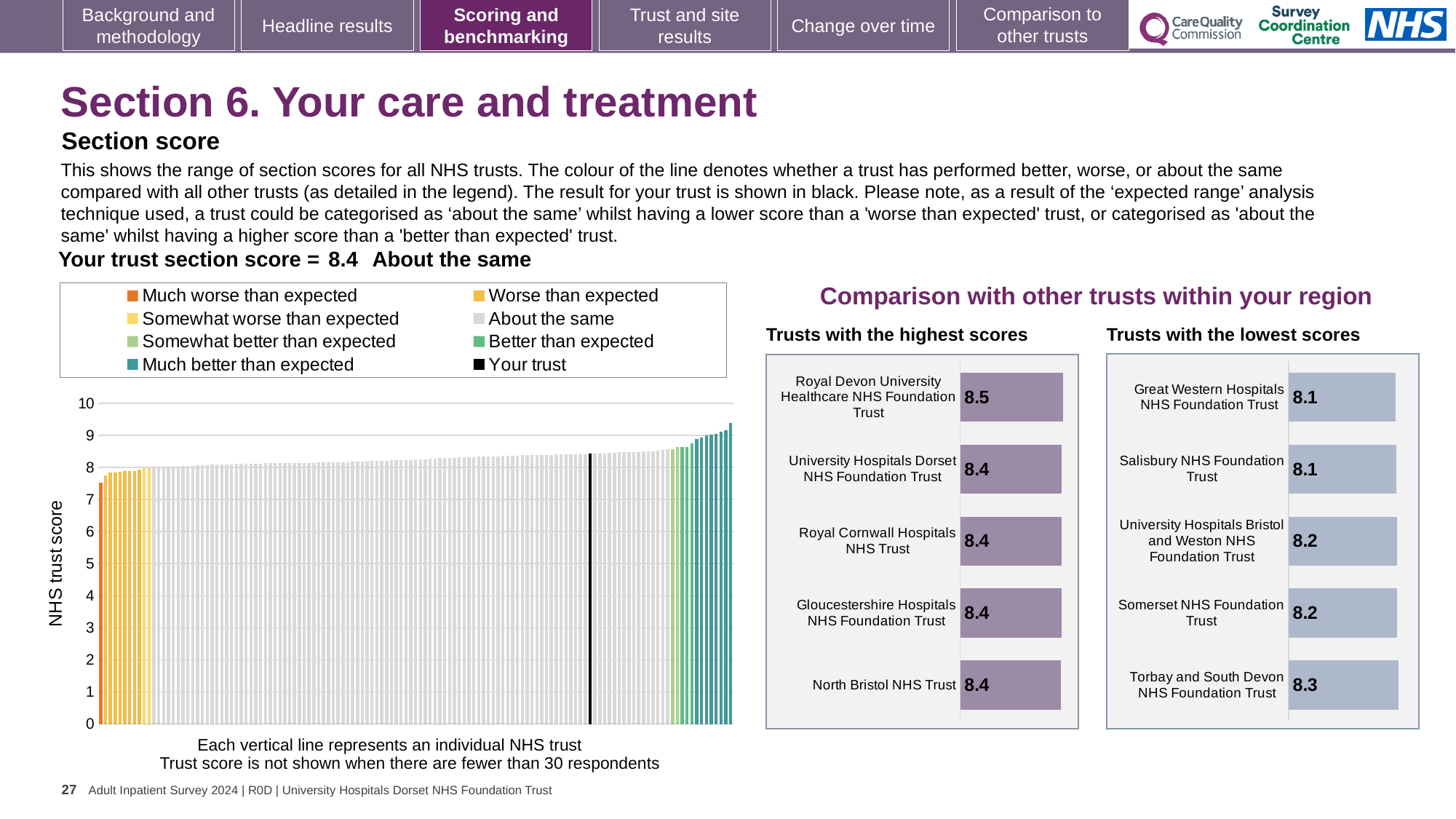
In the main NHS trust score chart on the left, is the value of the highest (rightmost) bar greater or less than 9? greater In the 'Trusts with the lowest scores' chart, what is the score for Torbay and South Devon NHS Foundation Trust? 8.3 In the 'Trusts with the lowest scores' chart, what is the score for Great Western Hospitals NHS Foundation Trust? 8.1 What kind of chart is the main NHS trust score chart on the left? bar chart In the 'Trusts with the highest scores' chart, which trust has the highest score? Royal Devon University Healthcare NHS Foundation Trust In the 'Trusts with the lowest scores' chart, which trust has the highest score? Torbay and South Devon NHS Foundation Trust In the 'Trusts with the lowest scores' chart, what is the difference between the scores of Torbay and South Devon NHS Foundation Trust and Salisbury NHS Foundation Trust? 0.2 In the main NHS trust score chart on the left, is the value of the lowest (leftmost) bar greater or less than 7? greater How many entries does the legend of the main NHS trust score chart list? 8 How many trusts are shown in the 'Trusts with the highest scores' chart? 5 In the 'Trusts with the highest scores' chart, what is the score for Royal Devon University Healthcare NHS Foundation Trust? 8.5 Which is larger: the score for Royal Devon University Healthcare NHS Foundation Trust in the highest scores chart, or the score for Somerset NHS Foundation Trust in the lowest scores chart? Royal Devon University Healthcare NHS Foundation Trust